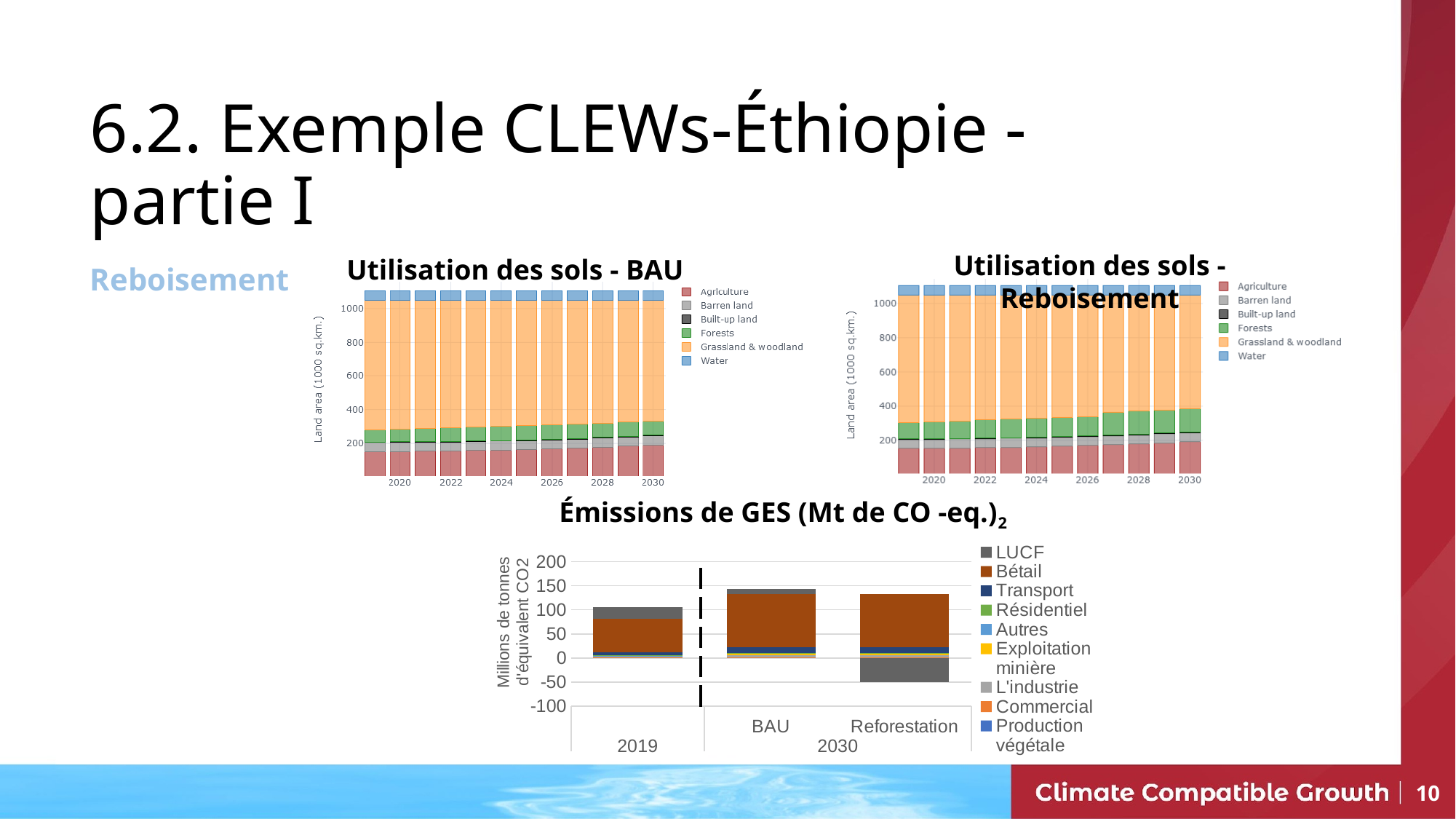
In the 'Émissions de GES' chart, is the LUCF value for Reforestation 2030 greater or less than 0? less What kind of chart is the 'Émissions de GES' chart at the bottom of the slide? Stacked bar chart How many series does the legend of the 'Utilisation des sols - BAU' chart list? 6 How many bars are plotted in the 'Émissions de GES' chart? 3 How many years (bars) are plotted in the 'Utilisation des sols - Reboisement' chart? 12 In the 'Utilisation des sols - BAU' chart, which land use category occupies the largest area? Grassland & woodland How many series does the legend of the 'Émissions de GES' chart list? 9 In the 'Émissions de GES' chart, which bar has the larger total positive emissions: 2019 or BAU 2030? BAU 2030 In the 'Émissions de GES' chart, which series accounts for the largest share of emissions in every bar? Bétail What is the y-axis label of the 'Utilisation des sols - BAU' chart? Land area (1000 sq.km.) In the 'Utilisation des sols - Reboisement' chart, does the Forests area rise or fall from 2020 to 2030? Rise In the 'Émissions de GES' chart, is the total positive emissions for BAU 2030 greater or less than 100? greater